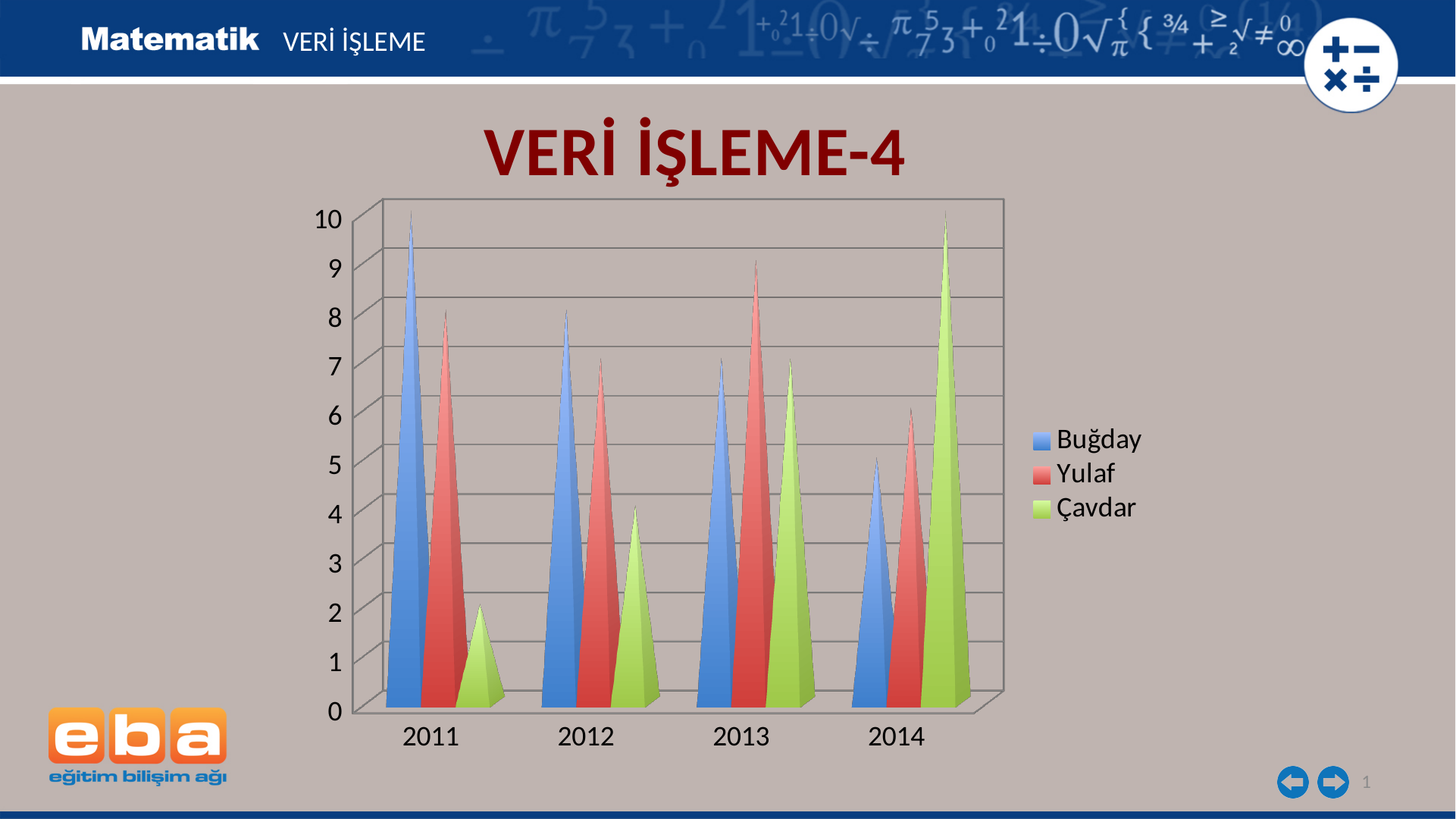
What is the value for Çavdar in 2011? 2 What is the value for Buğday in 2011? 10 What is the difference between Buğday and Çavdar in 2011? 8 Which is larger in 2012, Buğday or Çavdar? Buğday What is the value for Çavdar in 2014? 10 Is the value for Yulaf in 2014 greater or less than 8? less In which year is Çavdar highest? 2014 How many series does the legend list? 3 What is the value for Yulaf in 2013? 9 Does the value for Buğday rise or fall from 2011 to 2014? fall How many years are shown on the x axis? 4 In which year is Buğday lowest? 2014